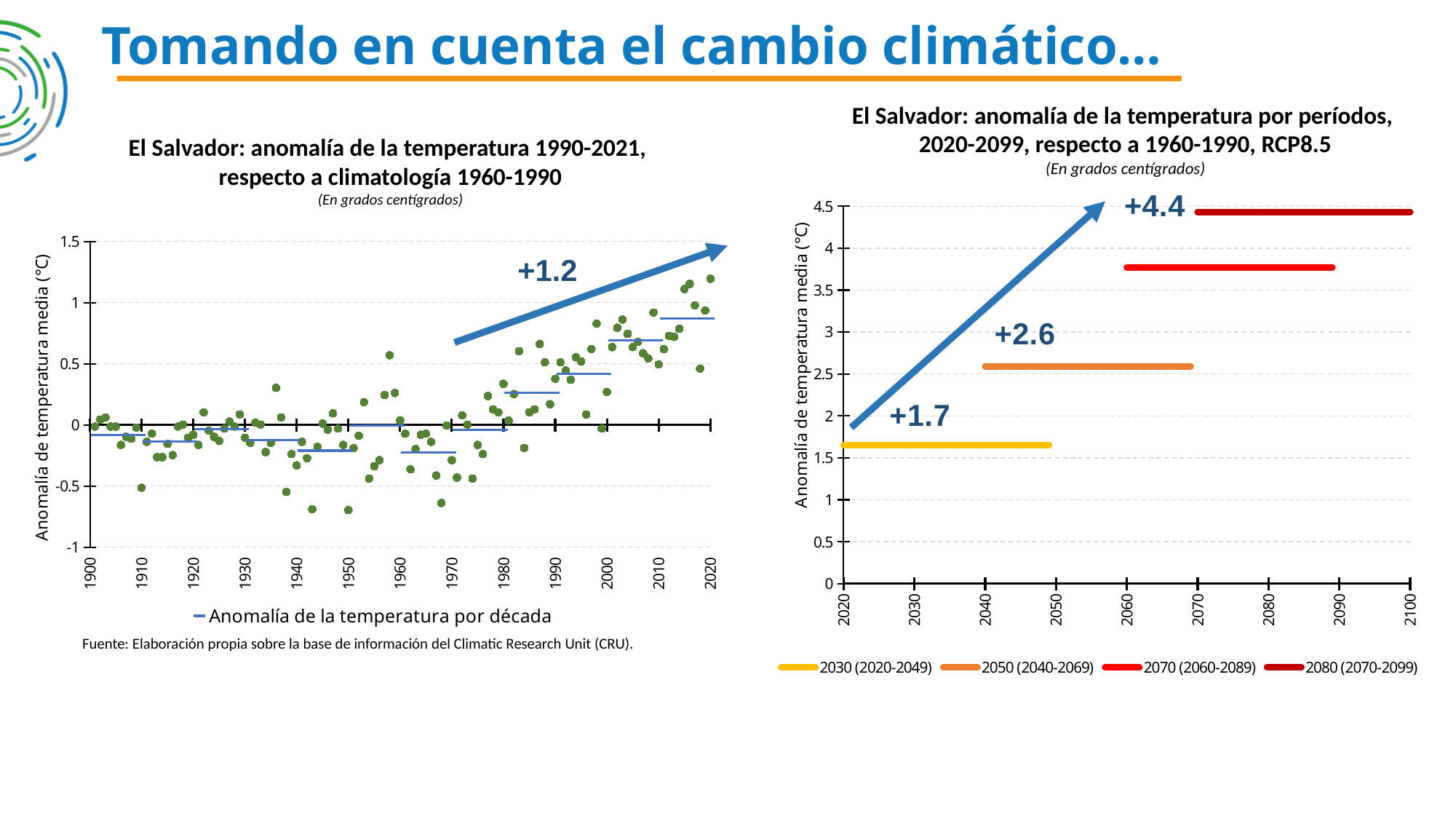
What is the legend entry shown below the left chart (anomalía de la temperatura 1990-2021)? Anomalía de la temperatura por década In the right chart (anomalía de la temperatura por períodos, RCP8.5), what is the difference between the labelled values for the 2080 (2070-2099) and 2030 (2020-2049) periods? 2.7 In the right chart (anomalía de la temperatura por períodos, RCP8.5), what is the labelled value for the 2030 (2020-2049) period? +1.7 In the right chart (anomalía de la temperatura por períodos, RCP8.5), is the value for the 2070 (2060-2089) period greater or less than 3.5? greater In the right chart (anomalía de la temperatura por períodos, RCP8.5), which period has the lowest temperature anomaly? 2030 (2020-2049) In the right chart (anomalía de la temperatura por períodos, RCP8.5), which period has the highest temperature anomaly? 2080 (2070-2099) In the left chart (anomalía de la temperatura 1990-2021), what change in temperature anomaly is indicated by the arrow annotation? +1.2 How many series does the legend of the right chart (anomalía de la temperatura por períodos, RCP8.5) list? 4 In the right chart (anomalía de la temperatura por períodos, RCP8.5), do the anomaly values rise or fall as the periods move later along the x axis? rise In the left chart (anomalía de la temperatura 1990-2021), is the decade anomaly line for the 2010s greater or less than 0.5? greater In the right chart (anomalía de la temperatura por períodos, RCP8.5), what is the labelled value for the 2050 (2040-2069) period? +2.6 In the right chart (anomalía de la temperatura por períodos, RCP8.5), what is the labelled value for the 2080 (2070-2099) period? +4.4